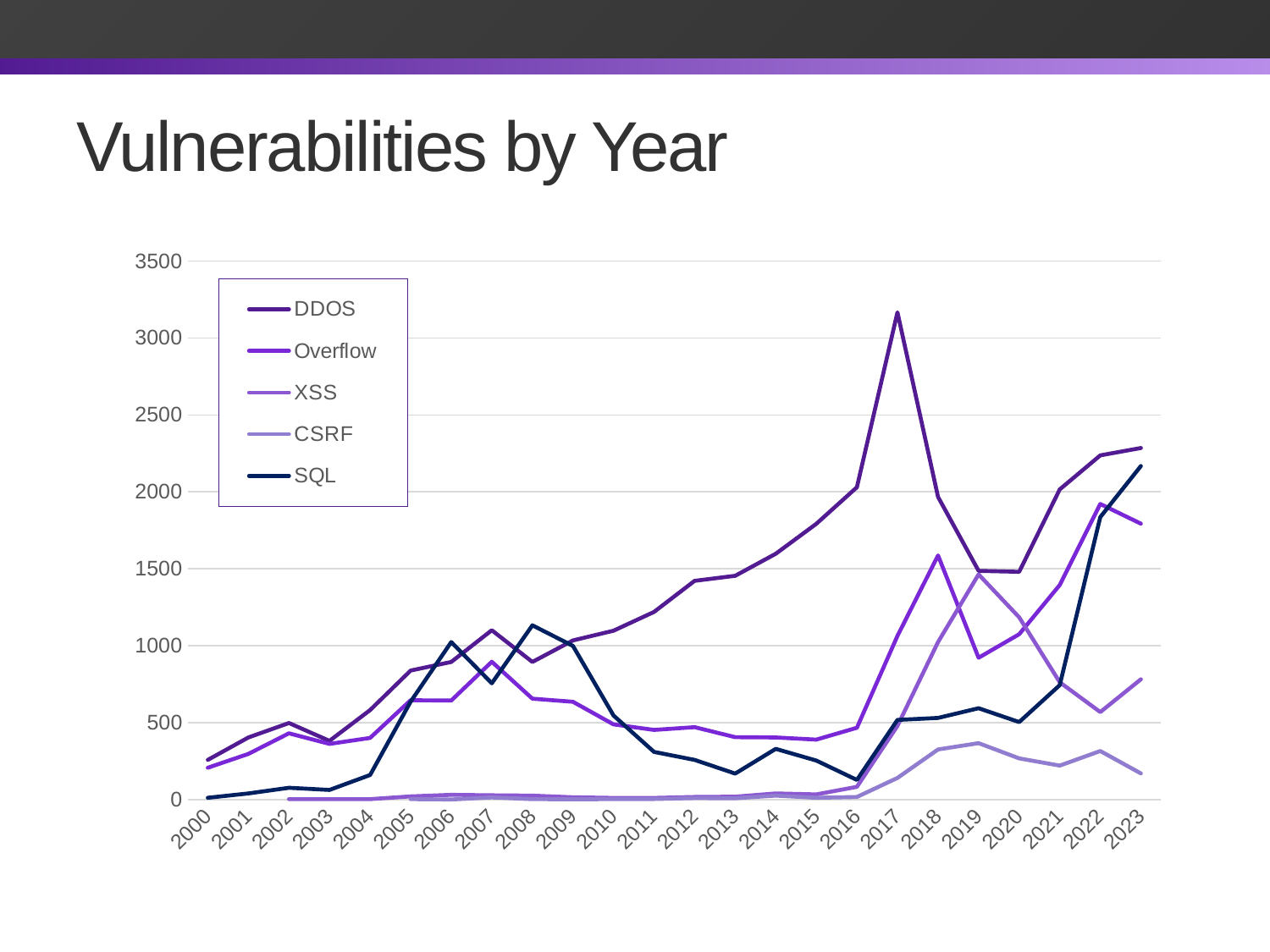
Is the value for SQL in 2023 greater or less than 2000? greater How many years are plotted along the x axis? 24 Which series has the lowest value in 2023? CSRF Is the value for DDOS in 2017 greater or less than 3000? greater Does the DDOS series generally rise or fall from 2000 to 2017? rise In 2018, which series has the larger value, XSS or SQL? XSS Is the value for CSRF in 2019 greater or less than 500? less In which year does the DDOS series reach its highest value? 2017 What kind of chart is shown on the slide? line chart What is the title of the chart? Vulnerabilities by Year In 2023, which series has the larger value, DDOS or CSRF? DDOS How many series does the legend list? 5